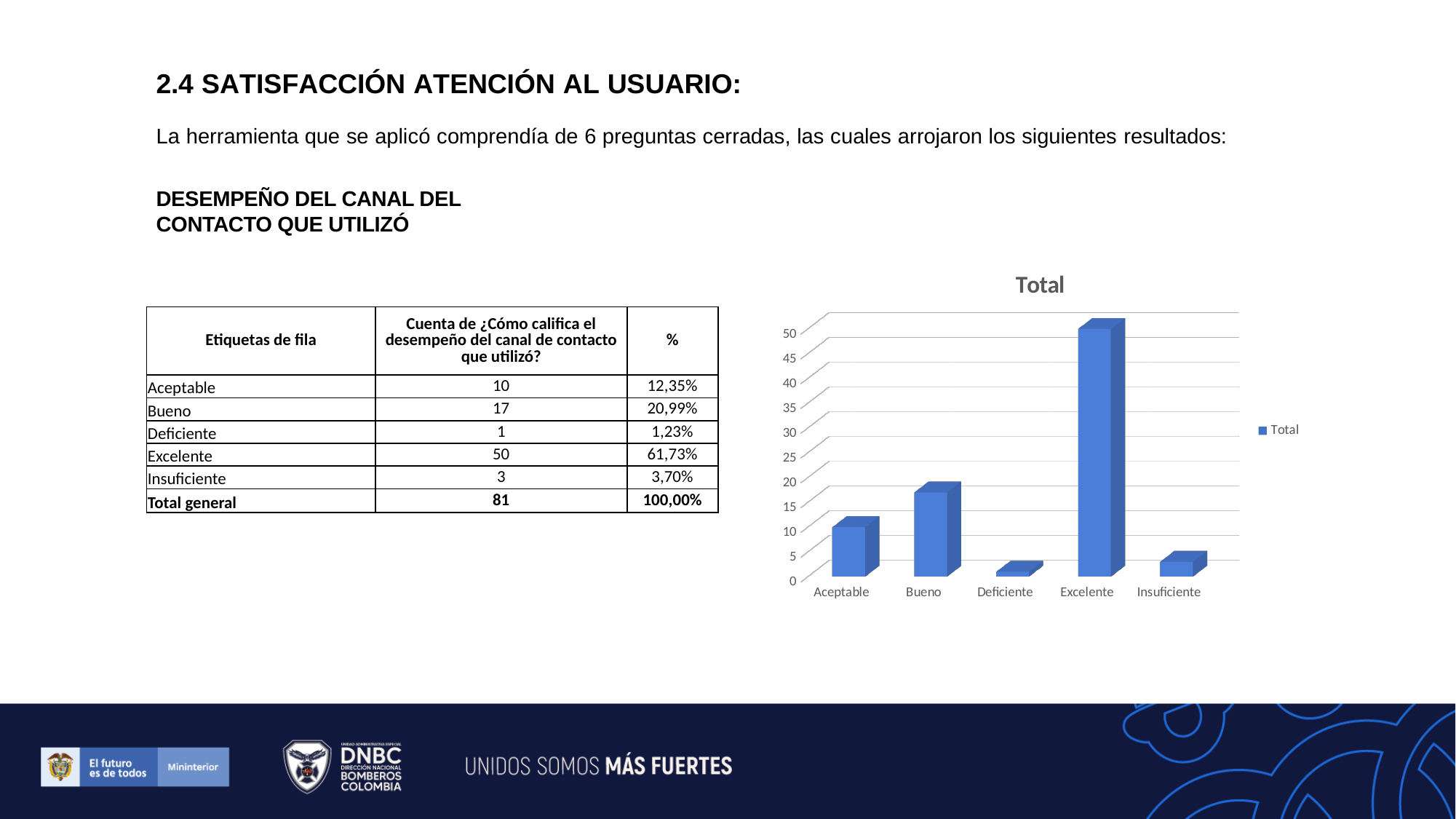
Which category has the lowest value in the chart? Deficiente How many categories are shown on the x axis of the chart? 5 How many series does the chart legend list? 1 Is the value for Insuficiente greater or less than 5? less What is the value for Bueno? 17 Which is larger, the value for Aceptable or the value for Bueno? Bueno What type of chart is shown on the slide? bar chart Is the value for Bueno greater or less than 15? greater What is the title of the chart? Total Which category has the highest value in the chart? Excelente What is the value for Aceptable? 10 What is the value for Excelente? 50